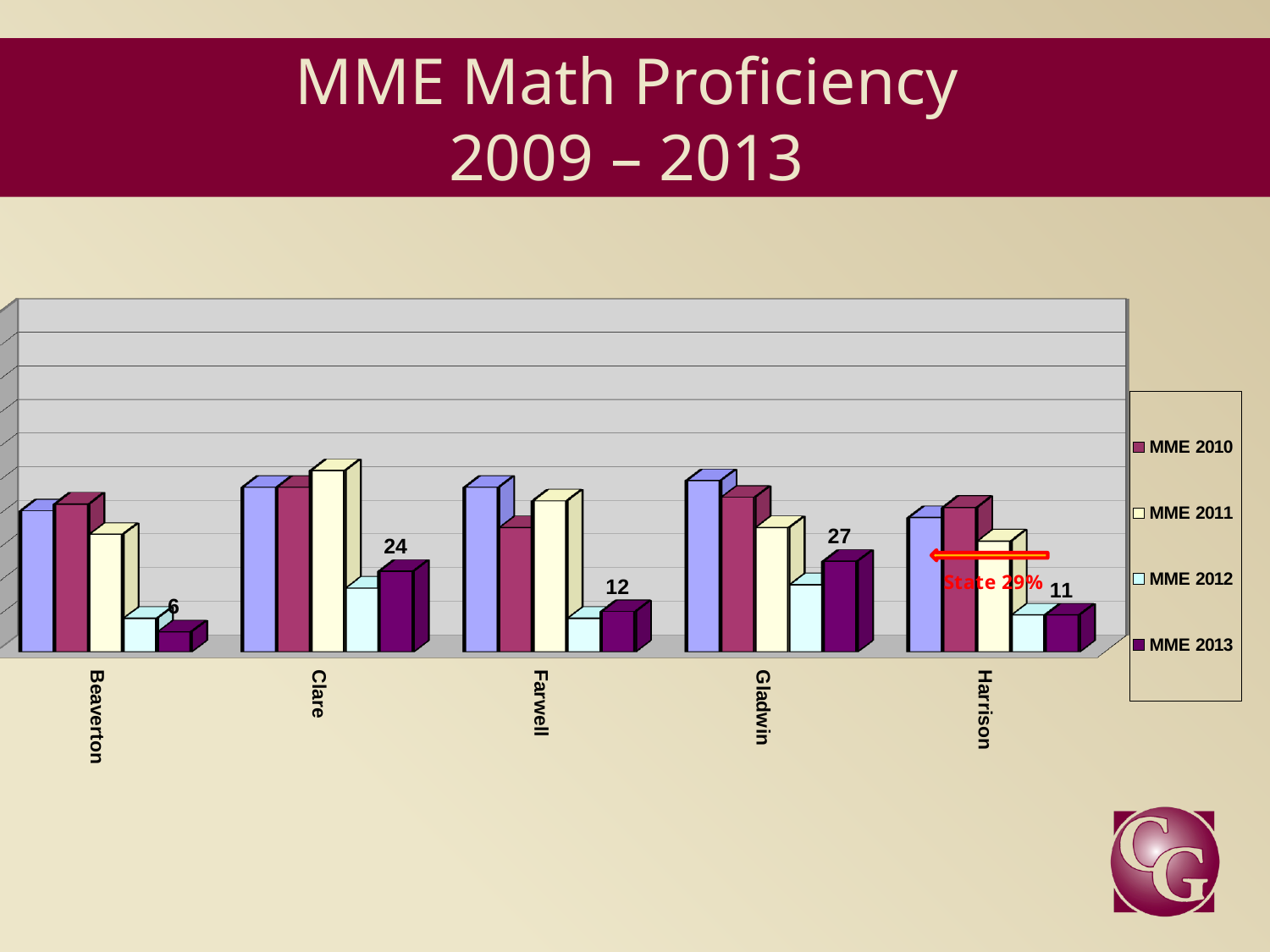
What is the MME 2013 value for Harrison? 11 What is the MME 2013 value for Beaverton? 6 What state proficiency percentage is annotated on the chart? 29% Which school has the lowest MME 2013 value? Beaverton Which school has the highest MME 2013 value? Gladwin What is the MME 2013 value for Clare? 24 What kind of chart is shown on the slide? Bar chart Which has the larger MME 2013 value, Farwell or Harrison? Farwell How many schools are shown on the x axis of the chart? 5 What is the MME 2013 value for Gladwin? 27 What is the difference between the MME 2013 values for Gladwin and Beaverton? 21 What is the MME 2013 value for Farwell? 12